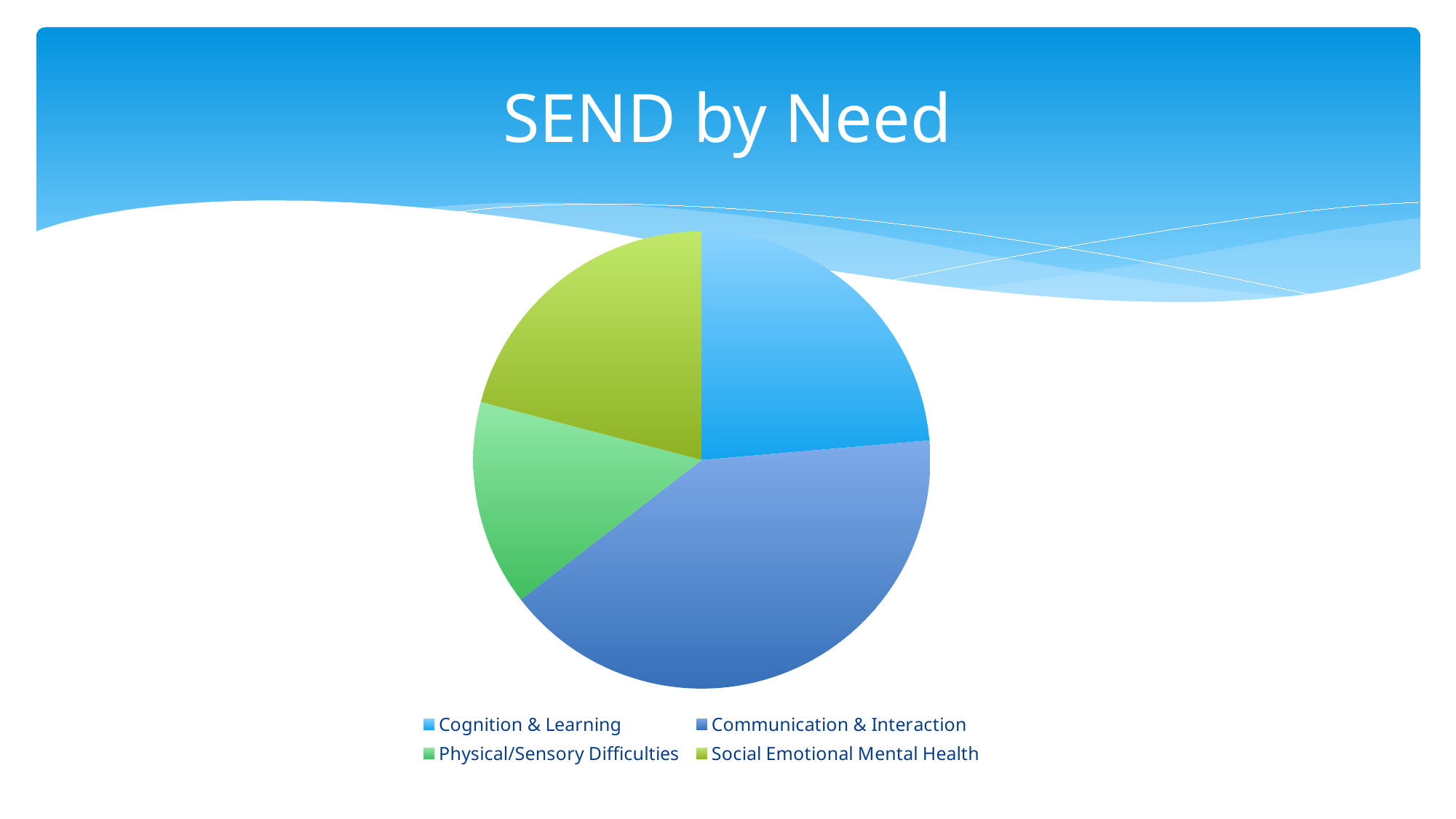
What is the title of the chart? SEND by Need Which slice is larger, Social Emotional Mental Health or Physical/Sensory Difficulties? Social Emotional Mental Health How many entries does the legend list? 4 What kind of chart is shown on the slide? pie chart Which category has the smallest slice of the pie? Physical/Sensory Difficulties Which category is shown in light blue in the legend? Cognition & Learning Which category has the largest slice of the pie? Communication & Interaction Which slice is larger, Cognition & Learning or Physical/Sensory Difficulties? Cognition & Learning How many categories does the pie chart show? 4 Which slice is larger, Communication & Interaction or Cognition & Learning? Communication & Interaction